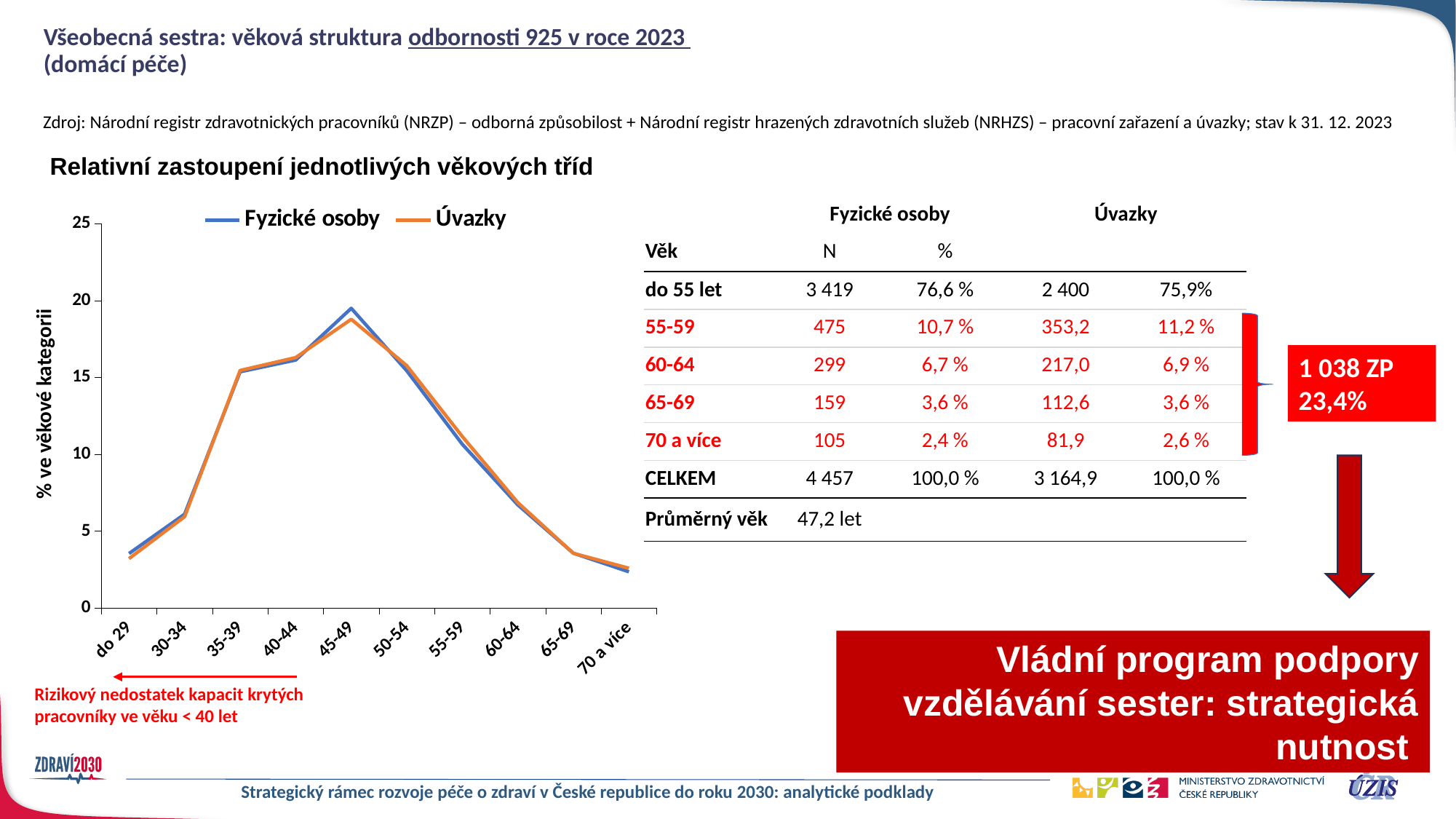
Is the value for Fyzické osoby in the 45-49 category greater or less than 15? greater Which age category has the lowest value for Úvazky in the chart? 70 a více What kind of chart is shown on the slide? line chart Which colour is used for the Úvazky series in the chart? orange Is the value for Úvazky in the do 29 category greater or less than 5? less Which is larger in the chart: the Fyzické osoby value for 30-34 or for 65-69? 30-34 How many series does the chart legend list? 2 How many age categories are shown on the x axis of the chart? 10 Which age category has the highest value for Fyzické osoby in the chart? 45-49 What is the label of the y axis of the chart? % ve věkové kategorii Is the value for Fyzické osoby in the 60-64 category greater or less than 10? less Do the values in the chart rise or fall from 45-49 to 70 a více? fall